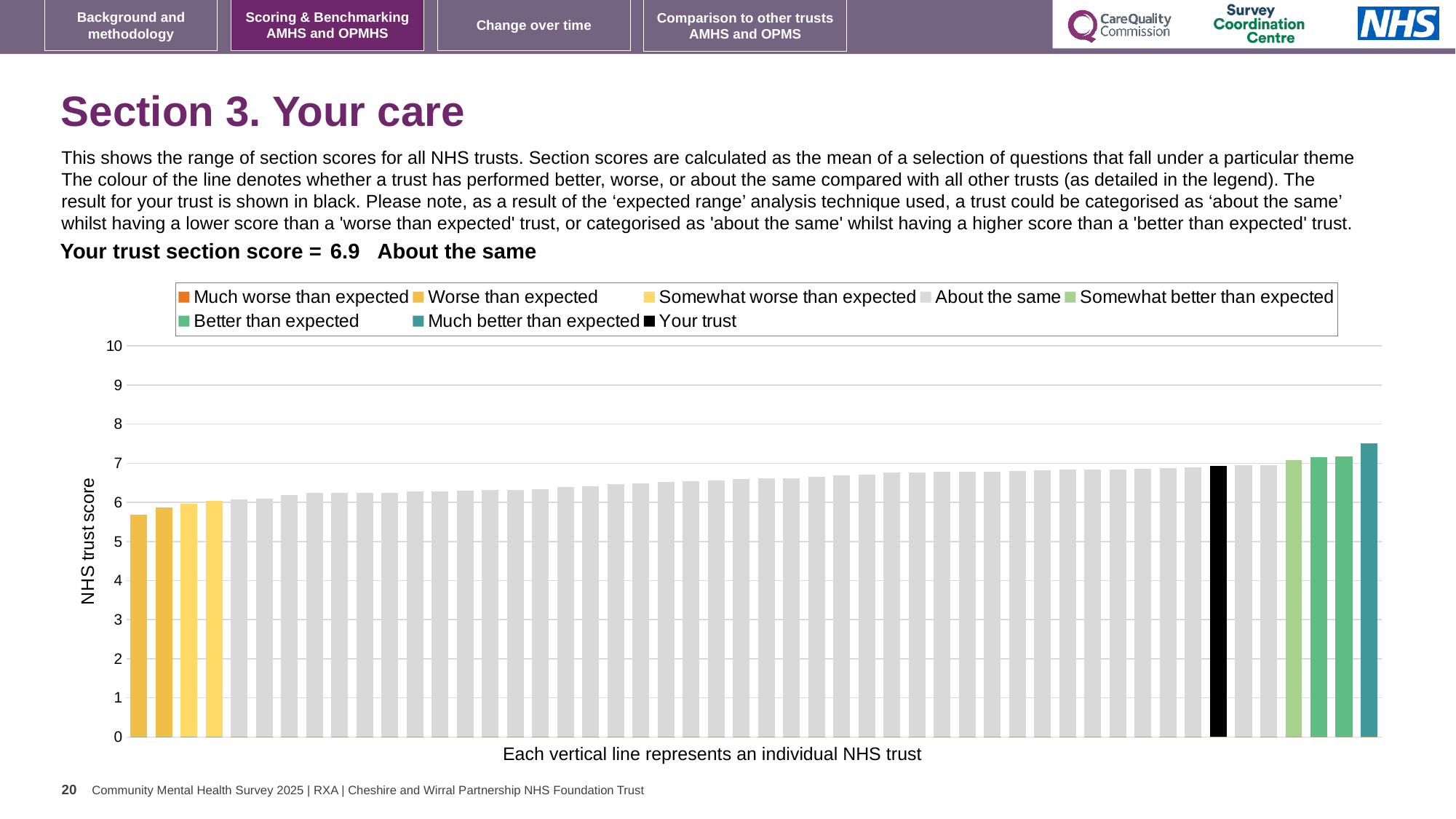
What kind of chart is shown on the slide? bar chart Which performance category is your trust placed in for Section 3? About the same Do the bar values rise or fall from left to right along the x axis? rise Is the value for your trust (the black bar) greater or less than 6? greater What is the label on the vertical axis of the chart? NHS trust score Which legend category does the highest bar belong to? Much better than expected Is the value of the highest bar greater or less than 7? greater How many bars are coloured as 'Better than expected'? 2 Is the value of the lowest bar greater or less than 6? less How many entries does the chart legend list? 8 What is the section score for your trust shown on the slide? 6.9